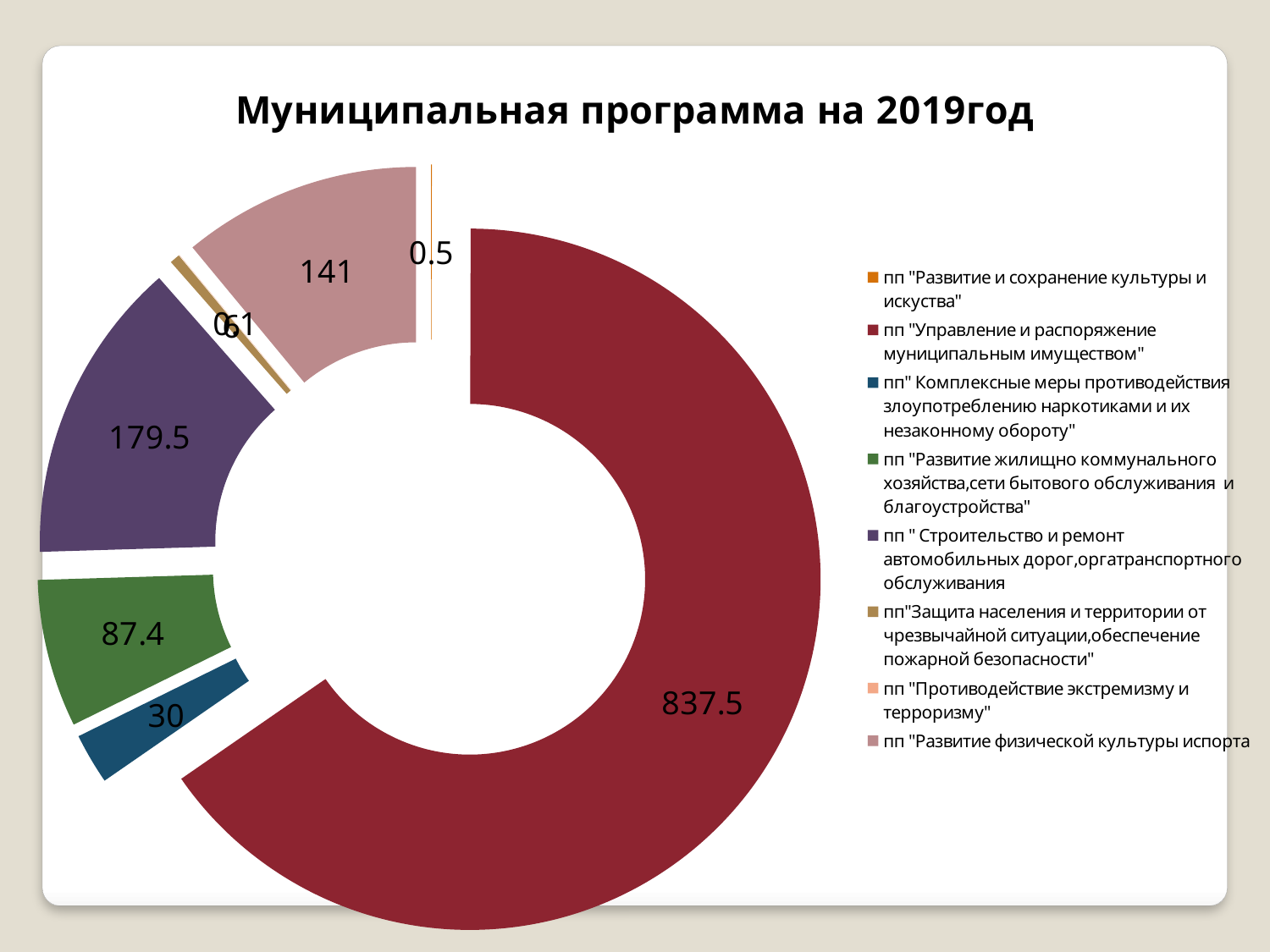
Which is larger: the value for road construction or the value for housing and communal services? road construction (179.5) What is the title of the chart? Муниципальная программа на 2019год What is the value for пп "Развитие жилищно коммунального хозяйства, сети бытового обслуживания и благоустройства"? 87.4 What is the value for пп "Развитие физической культуры и спорта"? 141 What kind of chart is shown on the slide? doughnut chart What is the value for пп "Развитие и сохранение культуры и искуства"? 0.5 What is the value for пп "Комплексные меры противодействия злоупотреблению наркотиками и их незаконному обороту"? 30 What is the value for пп "Строительство и ремонт автомобильных дорог, оргатранспортного обслуживания"? 179.5 What is the value for пп "Управление и распоряжение муниципальным имуществом"? 837.5 Which program has the largest value? пп "Управление и распоряжение муниципальным имуществом" What is the difference between the value for road construction (179.5) and the value for physical culture and sport (141)? 38.5 How many entries does the legend list? 8